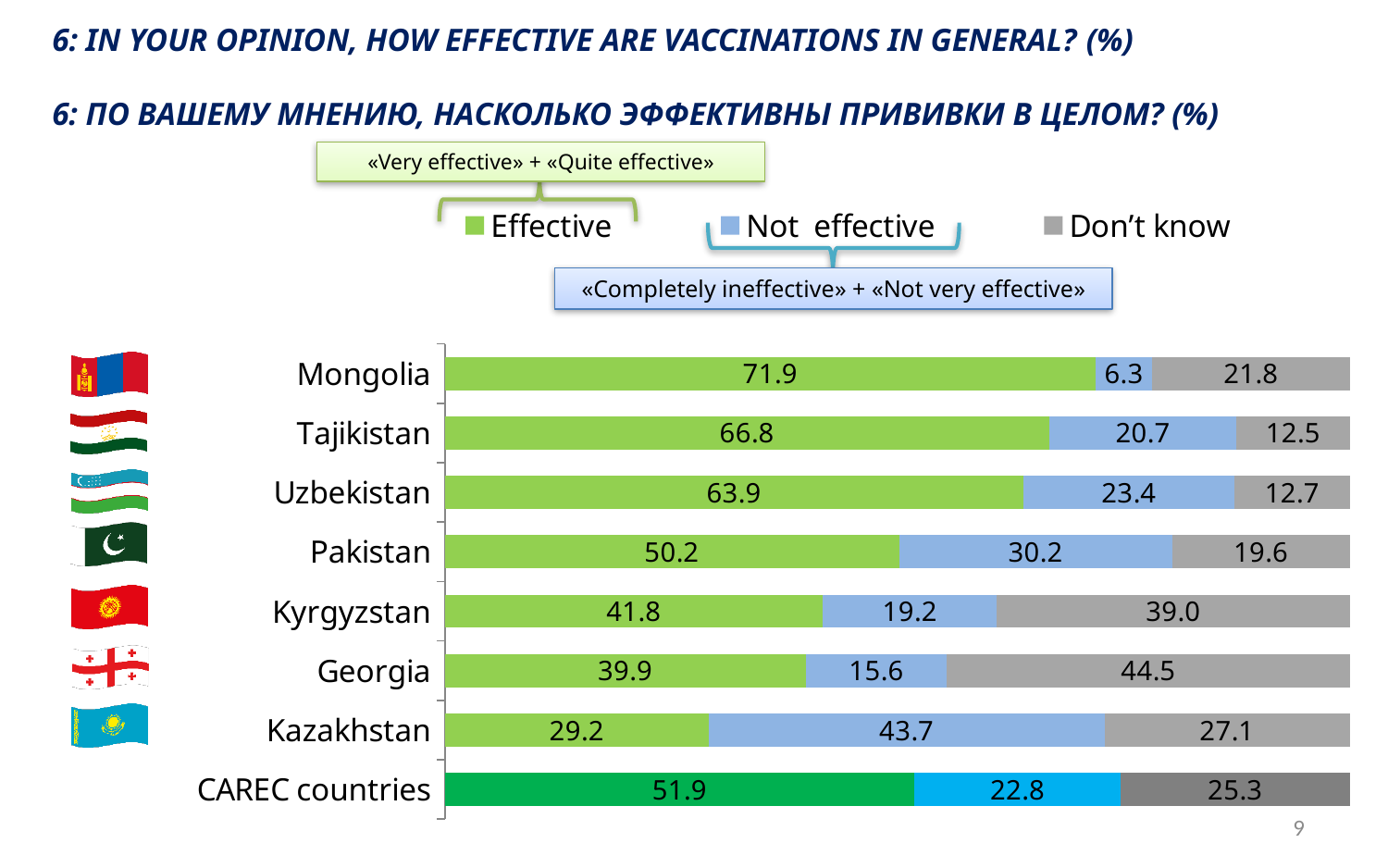
What kind of chart is shown on the slide? Stacked bar chart What is the total of the stacked bar for Pakistan? 100.0 How many series does the legend list? 3 Which is larger, the Don't know value for Kyrgyzstan or for Pakistan? Kyrgyzstan What is the Effective value for Mongolia? 71.9 Which category has the lowest Not effective value? Mongolia How many categories are shown on the chart? 8 What is the difference between the Effective values for Mongolia and Kazakhstan? 42.7 Which category has the highest Effective value? Mongolia What is the Not effective value for Kazakhstan? 43.7 What is the Effective value for CAREC countries? 51.9 What is the Don't know value for Georgia? 44.5